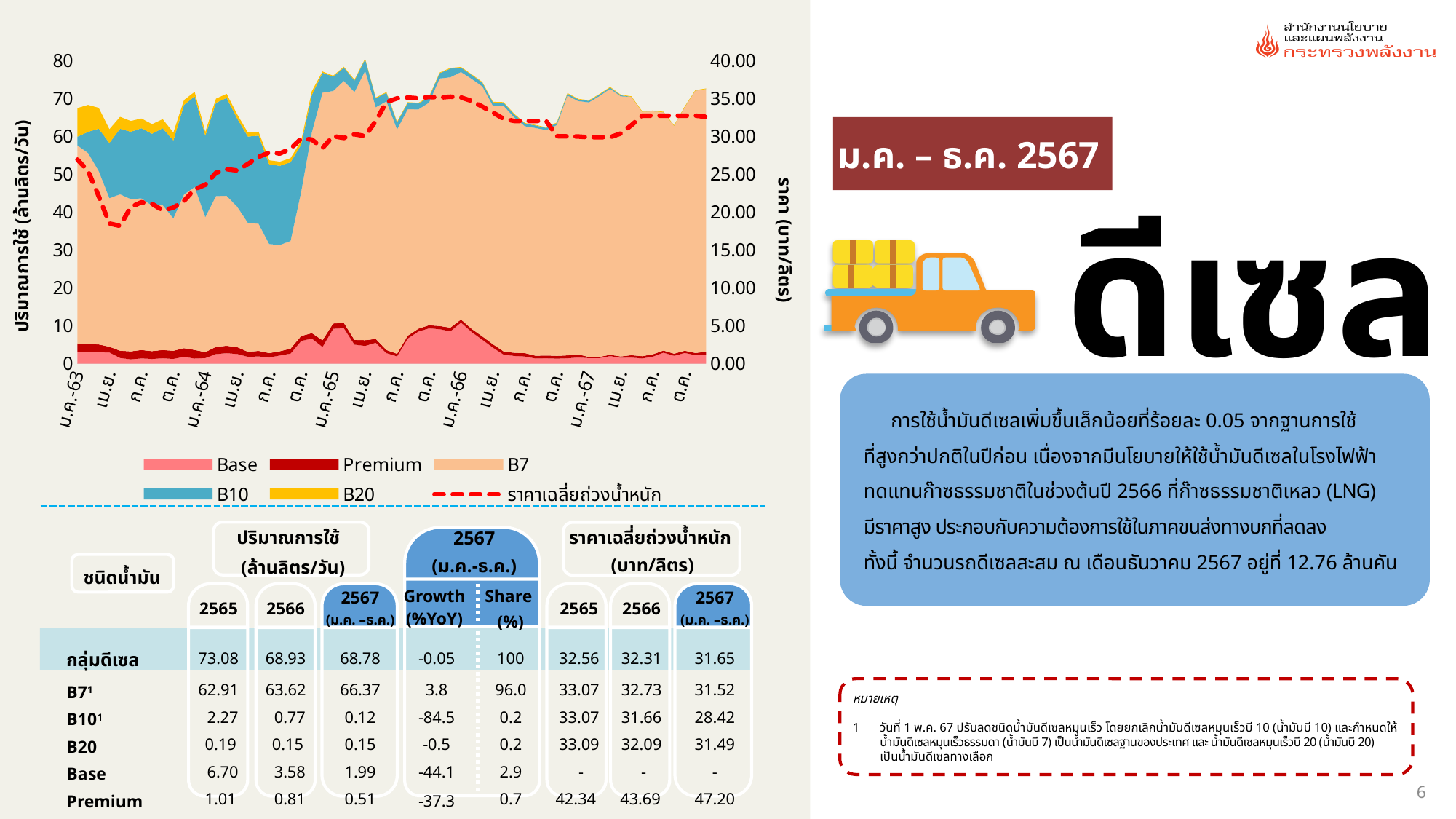
How many different years (63 to 67) are labelled on the x axis of the chart? 5 Is the value of the ราคาเฉลี่ยถ่วงน้ำหนัก line at ม.ค.-63 greater or less than 30.00? less Which series in the chart is drawn as a red dashed line? ราคาเฉลี่ยถ่วงน้ำหนัก Is the total stacked consumption at ม.ค.-65 greater or less than 70? greater Does the ราคาเฉลี่ยถ่วงน้ำหนัก line rise or fall overall from ม.ค.-63 to ต.ค.-65? rise Is the total stacked consumption at ก.ค.-64 greater or less than 40? greater How many series does the legend of the chart list? 6 What kind of chart is shown on the left of the slide? stacked area chart with a line What is the label of the right-hand vertical axis of the chart? ราคา (บาท/ลิตร) Is the B10 area larger at ม.ค.-64 or at ม.ค.-67? ม.ค.-64